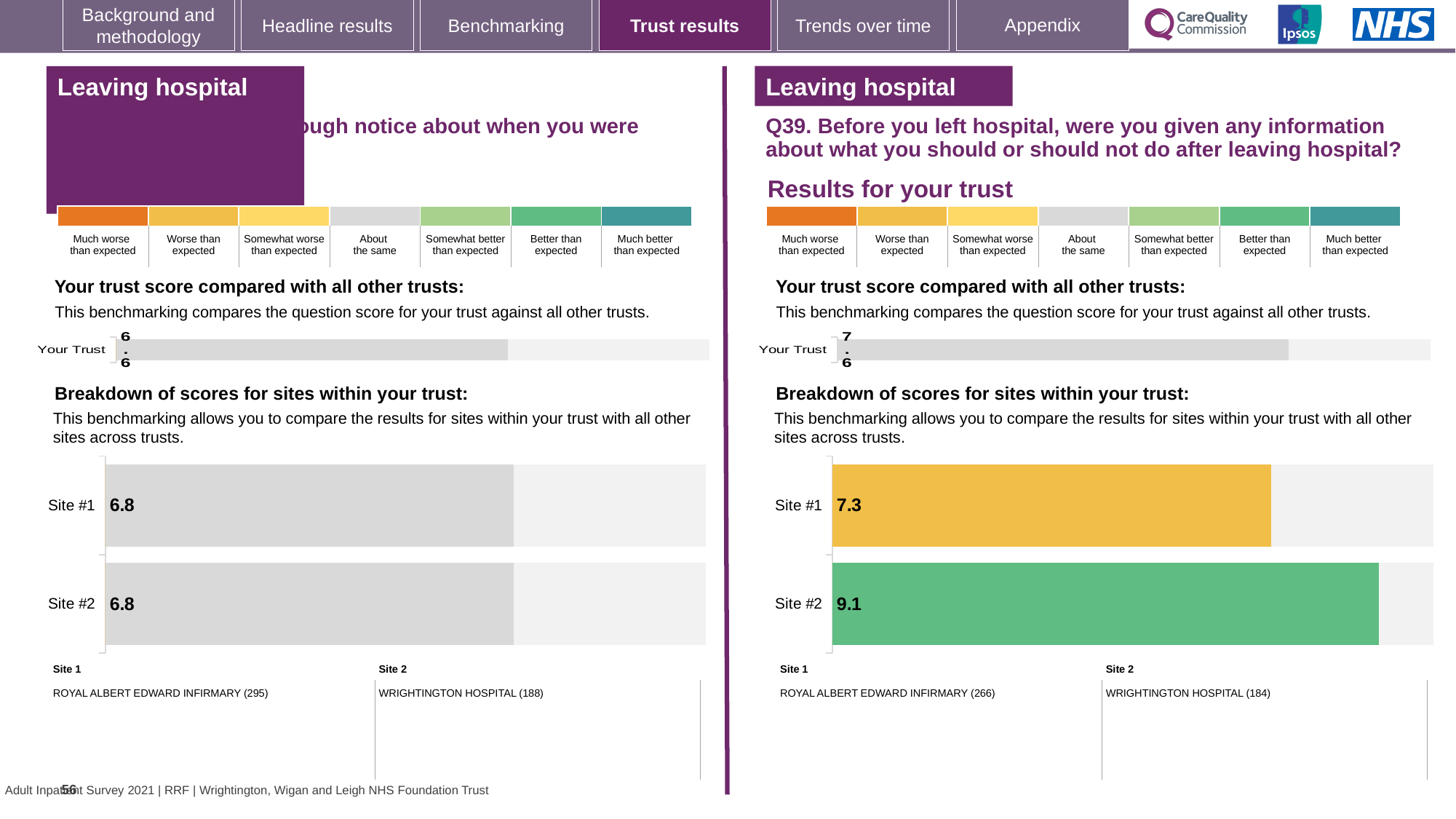
On the right-hand Q39 breakdown chart, what colour is the bar for Site #1? yellow What type of chart is used for the breakdown of scores for sites on the right-hand side? bar chart How many sites are shown in the right-hand Q39 breakdown chart? 2 On the right-hand Q39 chart, what is the score for Site #1? 7.3 On the left-hand breakdown chart, is the score for Site #1 larger than, smaller than, or equal to the score for Site #2? equal On the left-hand breakdown of scores for sites chart, what is the score for Site #1? 6.8 On the right-hand Q39 breakdown chart, what is the difference between the Site #2 and Site #1 scores? 1.8 On the right-hand Q39 breakdown chart, what colour is the bar for Site #2? green On the right-hand Q39 'Your trust score compared with all other trusts' chart, what is the score for Your Trust? 7.6 On the right-hand Q39 breakdown chart, which site has the higher score? Site #2 On the right-hand Q39 chart, what is the score for Site #2? 9.1 On the left-hand 'Your trust score compared with all other trusts' chart, what is the score for Your Trust? 6.6